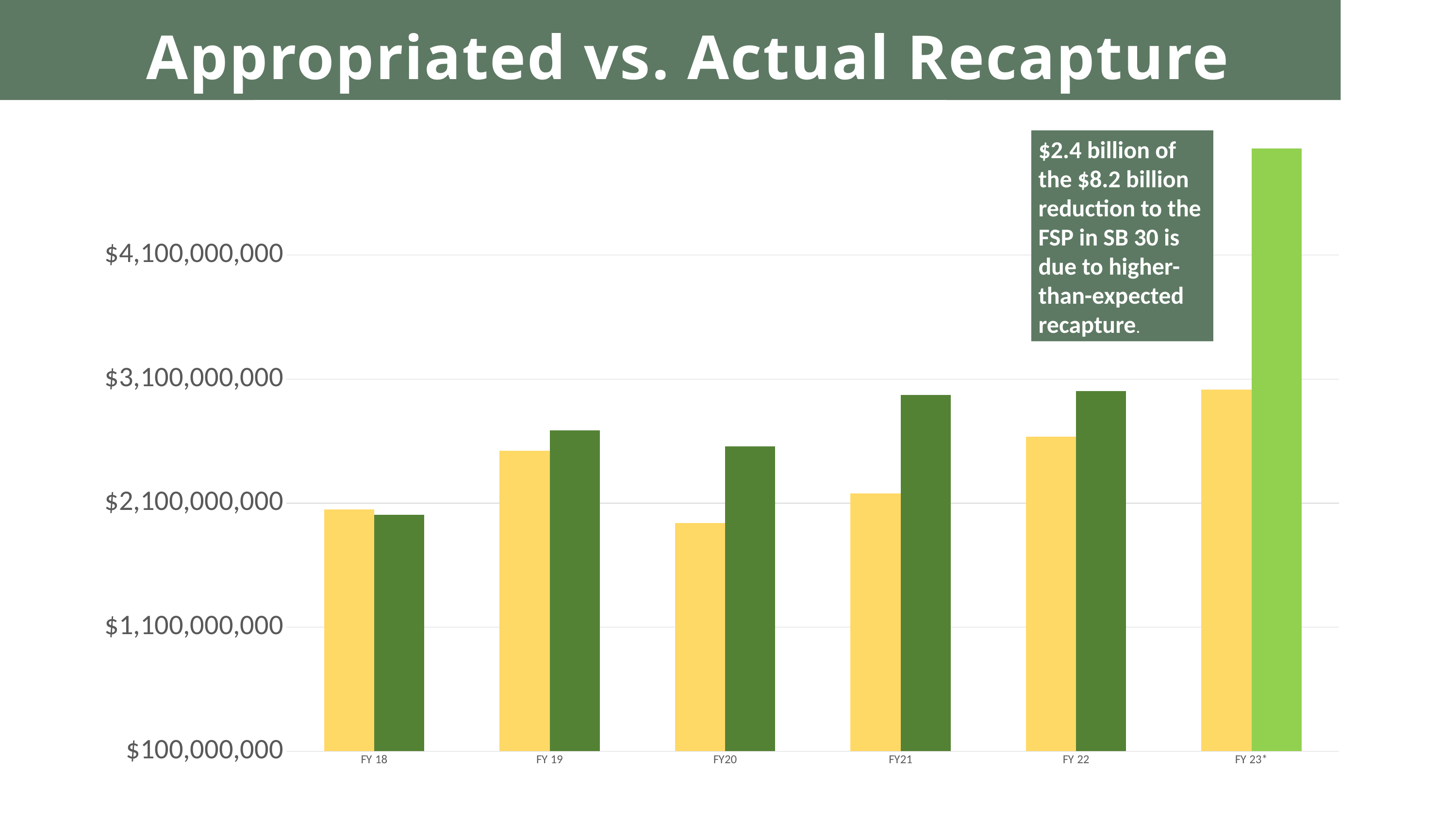
How many fiscal year categories are shown on the x axis? 6 Is the value of the dark green bar for FY 22 greater or less than $3,100,000,000? less How many bars are plotted for each fiscal year? 2 Do the green bars generally rise or fall from FY 18 to FY 23*? rise Which fiscal year has the tallest bar on the chart? FY 23* Is the value of the green bar for FY 23* greater or less than $4,100,000,000? greater What kind of chart is shown on the slide? bar chart Is the value of the yellow bar for FY20 greater or less than $2,100,000,000? less What is the title of the chart? Appropriated vs. Actual Recapture For FY21, which bar is taller, the yellow bar or the dark green bar? the dark green bar Which is larger, the green bar for FY 22 or the green bar for FY 23*? the green bar for FY 23*